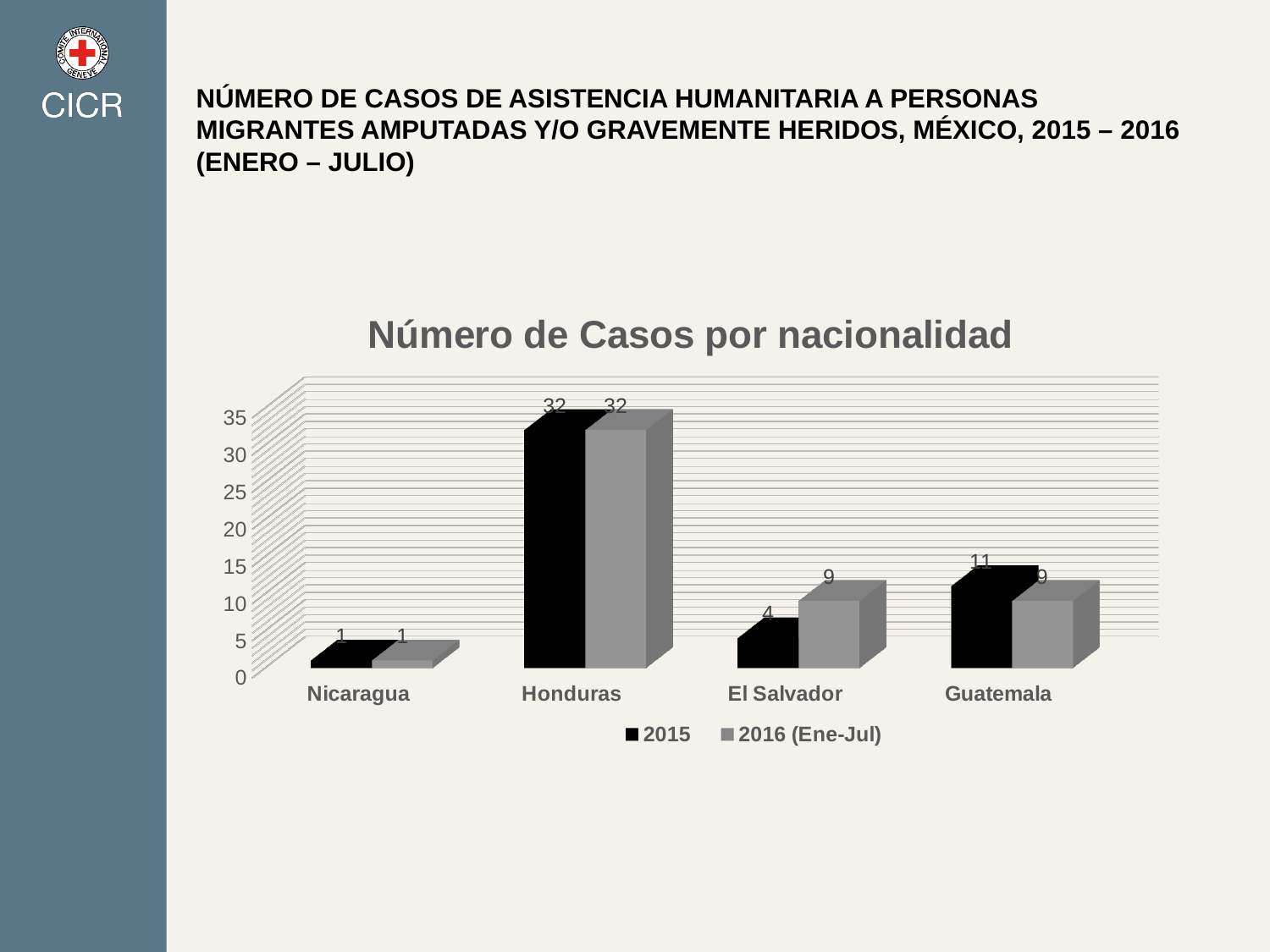
What is the value for El Salvador in the 2016 (Ene-Jul) series? 9 Which country has the lowest value in the 2016 (Ene-Jul) series? Nicaragua How many series does the legend list? 2 What is the value for Guatemala in the 2015 series? 11 What is the value for Nicaragua in the 2016 (Ene-Jul) series? 1 What is the difference between the 2016 (Ene-Jul) and 2015 values for El Salvador? 5 What kind of chart is shown? Bar chart What is the value for Honduras in the 2015 series? 32 How many countries are shown on the x axis? 4 Which country has the highest value in the 2015 series? Honduras What is the title of the chart? Número de Casos por nacionalidad Which is larger for Guatemala: the 2015 value or the 2016 (Ene-Jul) value? 2015